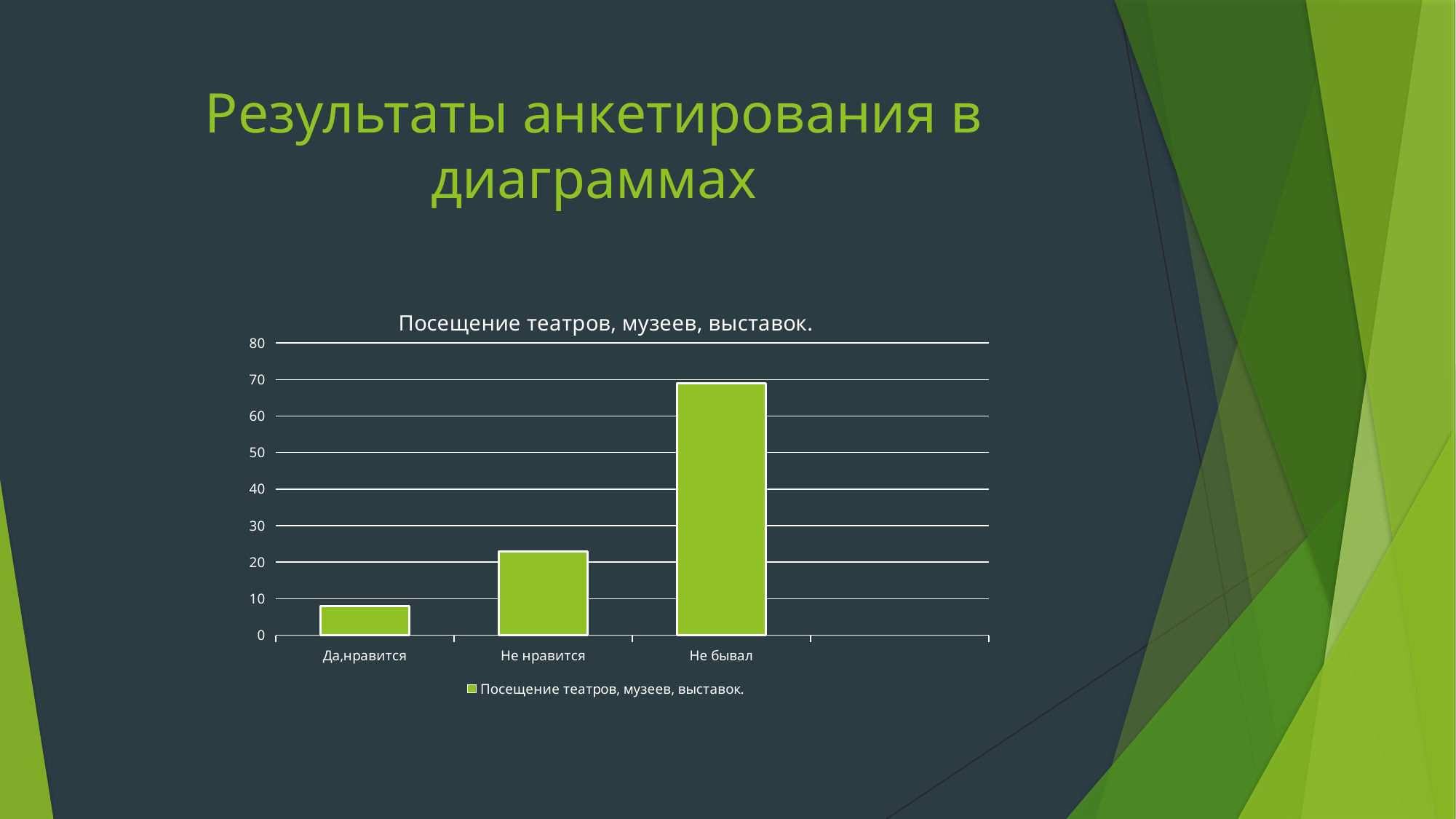
What is the title of the chart? Посещение театров, музеев, выставок. Is the value for Да,нравится greater or less than 10? less What kind of chart is shown on the slide? bar chart Which category has the highest value? Не бывал Is the value for Не нравится greater or less than 20? greater How many categories are shown on the x axis of the chart? 3 Which category has the lowest value? Да,нравится Is the value for Не бывал greater or less than 60? greater Which is larger, the value for Не нравится or the value for Да,нравится? Не нравится Do the values rise or fall from left to right along the x axis? rise How many series does the legend list? 1 What colour are the bars in the chart? green